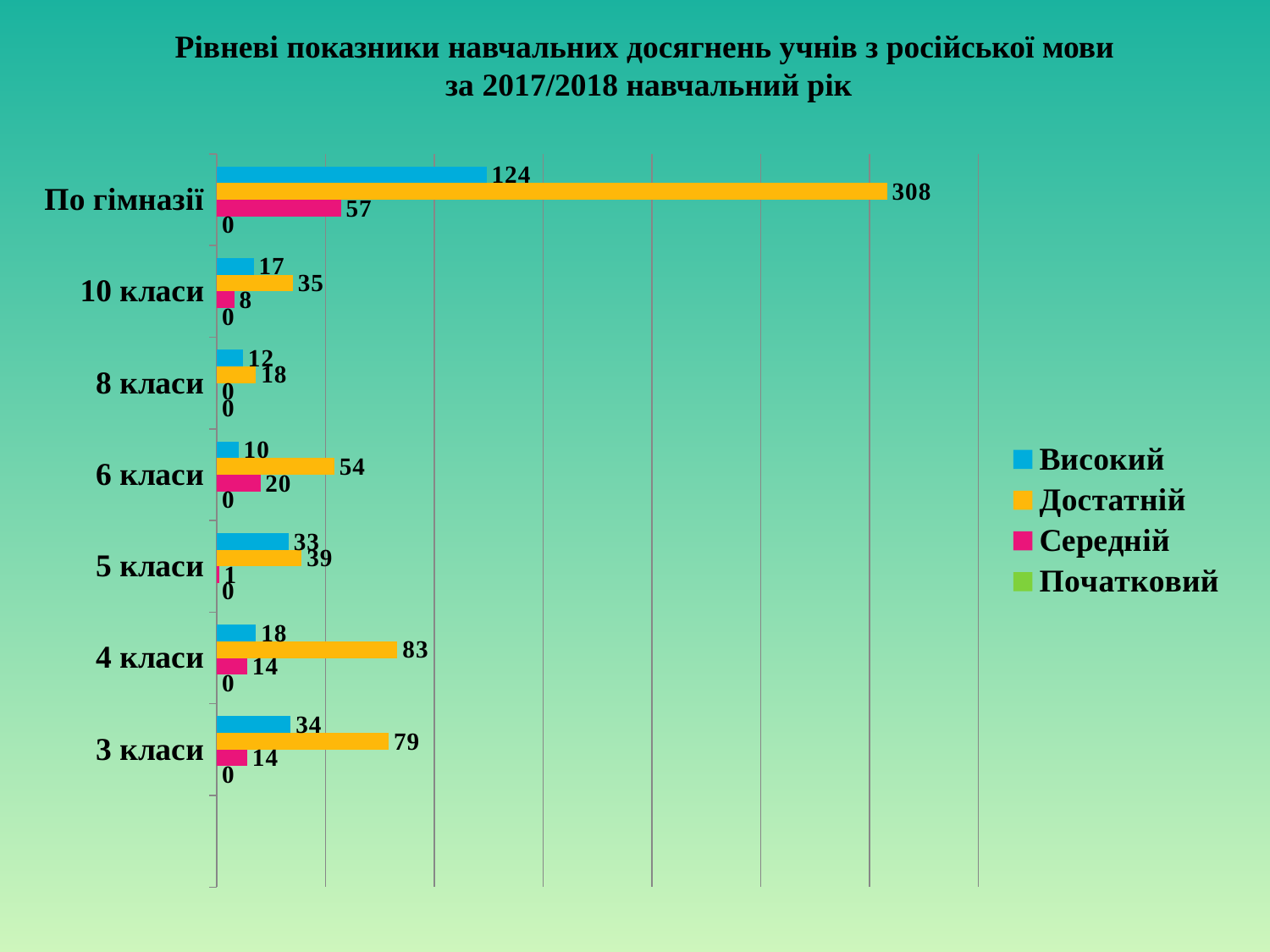
Which class category has the lowest Високий value? 6 класи What is the value of Високий for 3 класи? 34 How many series does the legend list? 4 Which class category has the highest Достатній value (excluding По гімназії)? 4 класи What is the difference between the Достатній values for 4 класи and 3 класи? 4 What is the value of Початковий for 10 класи? 0 What is the value of Достатній for По гімназії? 308 Which series is shown in pink/magenta in the legend? Середній What is the value of Середній for 6 класи? 20 What kind of chart is shown on the slide? bar chart How many categories are shown on the vertical axis? 7 Which is larger: the Високий value for 5 класи or the Високий value for 4 класи? 5 класи